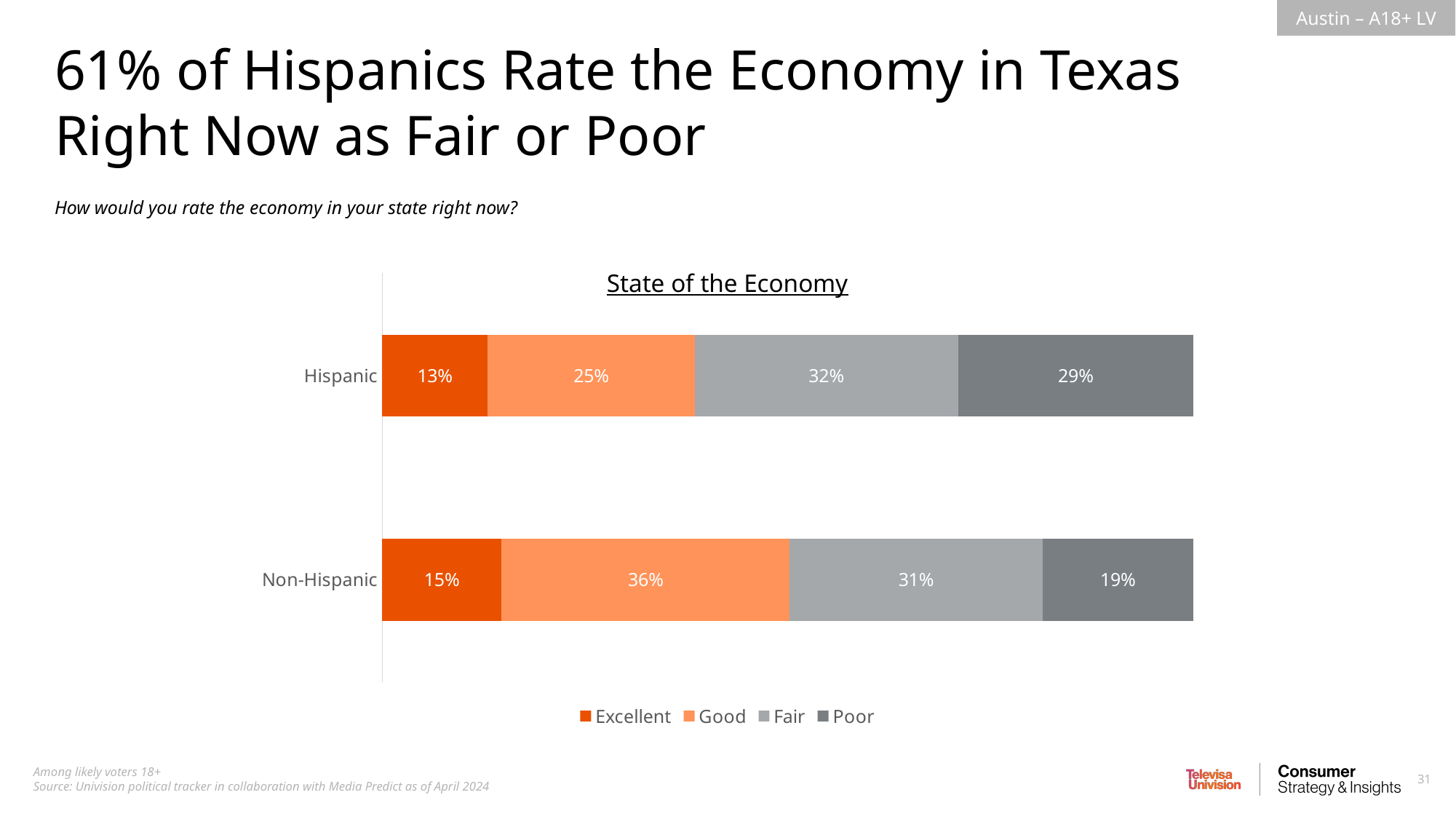
Which group has a larger Poor share, Hispanic or Non-Hispanic? Hispanic Which rating has the largest share among Hispanic respondents? Fair What percentage of Hispanic respondents rate the economy as Excellent? 13% What is the difference between the Good share for Non-Hispanic and Hispanic respondents? 11 percentage points What is the title of the chart? State of the Economy Which rating has the smallest share among Non-Hispanic respondents? Excellent How many series does the legend list? 4 How many groups are shown on the chart? 2 What is the combined Fair and Poor share for Hispanic respondents? 61% What kind of chart is shown on the slide? Stacked bar chart What percentage of Hispanic respondents rate the economy as Poor? 29% What percentage of Non-Hispanic respondents rate the economy as Good? 36%